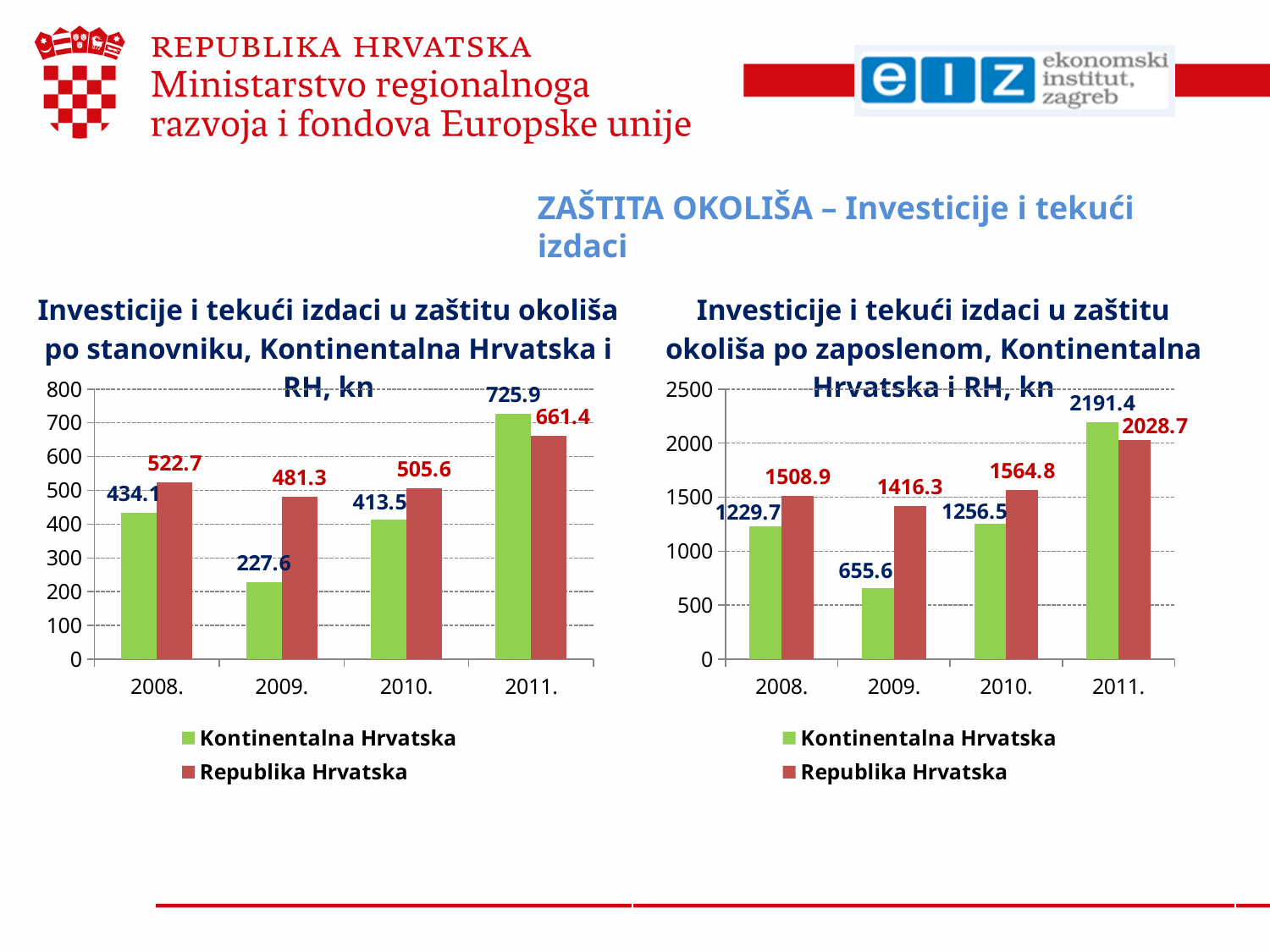
In the right chart (per zaposlenom), what is the value for Republika Hrvatska in 2009.? 1416.3 In the right chart (per zaposlenom), which year has the lowest value for Kontinentalna Hrvatska? 2009. In the left chart (per stanovniku), which year has the highest value for Kontinentalna Hrvatska? 2011. In the right chart (per zaposlenom), is the value for Republika Hrvatska in 2010. greater or less than 1500? greater In the right chart (per zaposlenom), which is larger in 2011., Kontinentalna Hrvatska or Republika Hrvatska? Kontinentalna Hrvatska In the left chart (per stanovniku), what is the difference between Republika Hrvatska and Kontinentalna Hrvatska in 2009.? 253.7 What type of chart is the left chart (per stanovniku)? Bar chart In the left chart (per stanovniku), what is the value for Republika Hrvatska in 2011.? 661.4 In the right chart (per zaposlenom), what is the value for Kontinentalna Hrvatska in 2011.? 2191.4 How many series does the legend of the right chart (per zaposlenom) list? 2 In the left chart (per stanovniku), what is the value for Kontinentalna Hrvatska in 2009.? 227.6 How many years are shown on the x axis of the left chart (per stanovniku)? 4